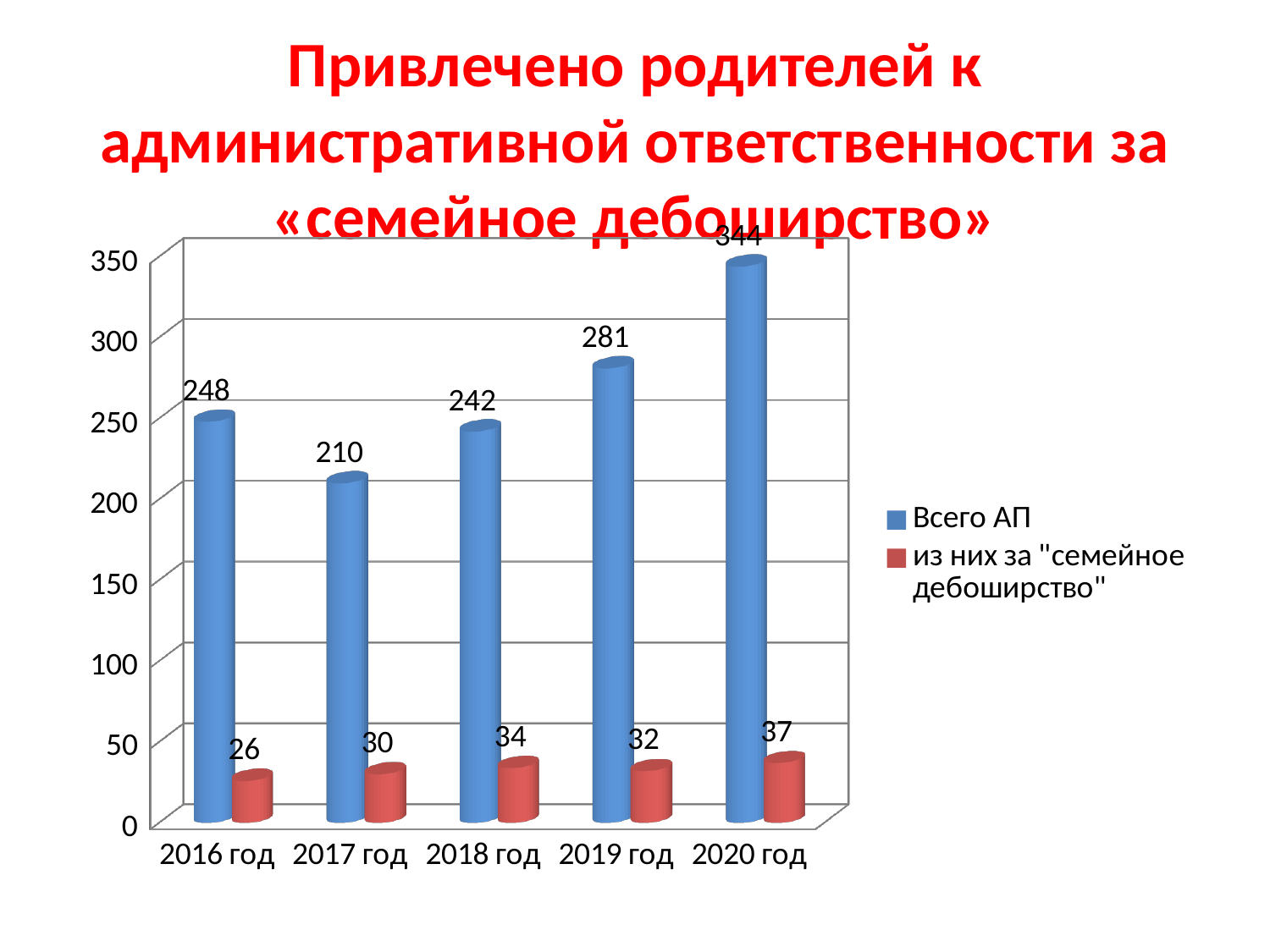
What is the difference between the "Всего АП" values for 2020 год and 2019 год? 63 How many series does the legend list? 2 Which year has the highest value for "Всего АП"? 2020 год What is the value of "Всего АП" for 2017 год? 210 What is the value of "Всего АП" for 2019 год? 281 What kind of chart is shown on the slide? bar chart Which is larger: the "Всего АП" value for 2016 год or for 2018 год? 2016 год Does the "Всего АП" series rise or fall from 2017 год to 2020 год? rise Which year has the lowest value for "из них за "семейное дебоширство""? 2016 год Is the value of "Всего АП" for 2018 год greater or less than 200? greater What is the value of "из них за "семейное дебоширство"" for 2016 год? 26 How many years are shown on the x axis? 5